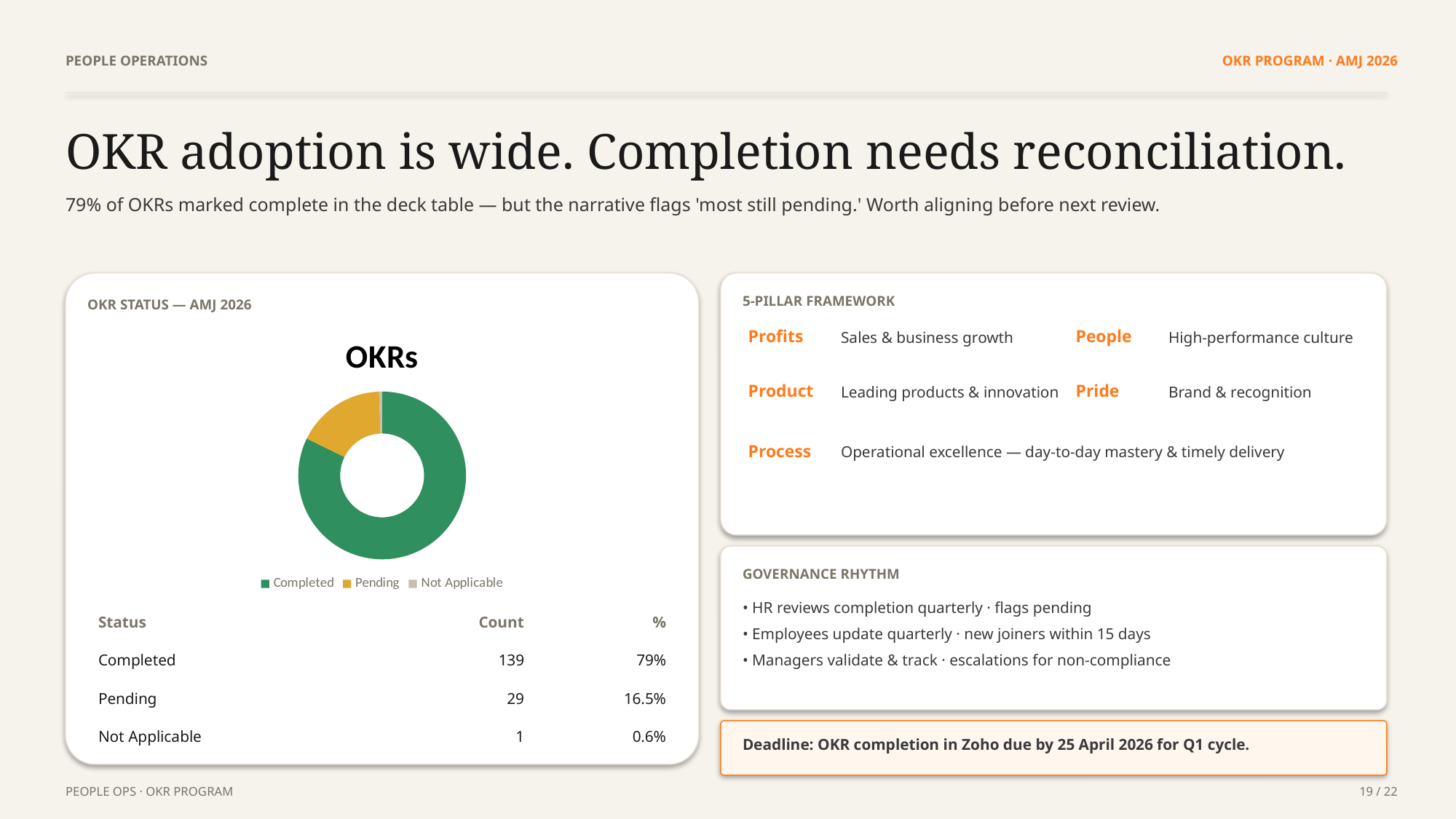
What is the difference in count between Completed and Pending OKRs? 110 According to the OKR status table, what is the count for Pending? 29 What share of OKRs is Completed, as shown in the OKR status table? 79% According to the OKR status table, what is the count for Completed? 139 What share of OKRs is Pending, as shown in the OKR status table? 16.5% What kind of chart is the "OKRs" chart? Pie chart (donut) Which category has the smallest slice in the "OKRs" chart? Not Applicable How many categories does the "OKRs" chart's legend list? 3 Which category has the largest slice in the "OKRs" chart? Completed What colour is the Completed slice in the "OKRs" chart? Green Which is larger in the "OKRs" chart, the Pending slice or the Not Applicable slice? Pending According to the OKR status table, what is the count for Not Applicable? 1